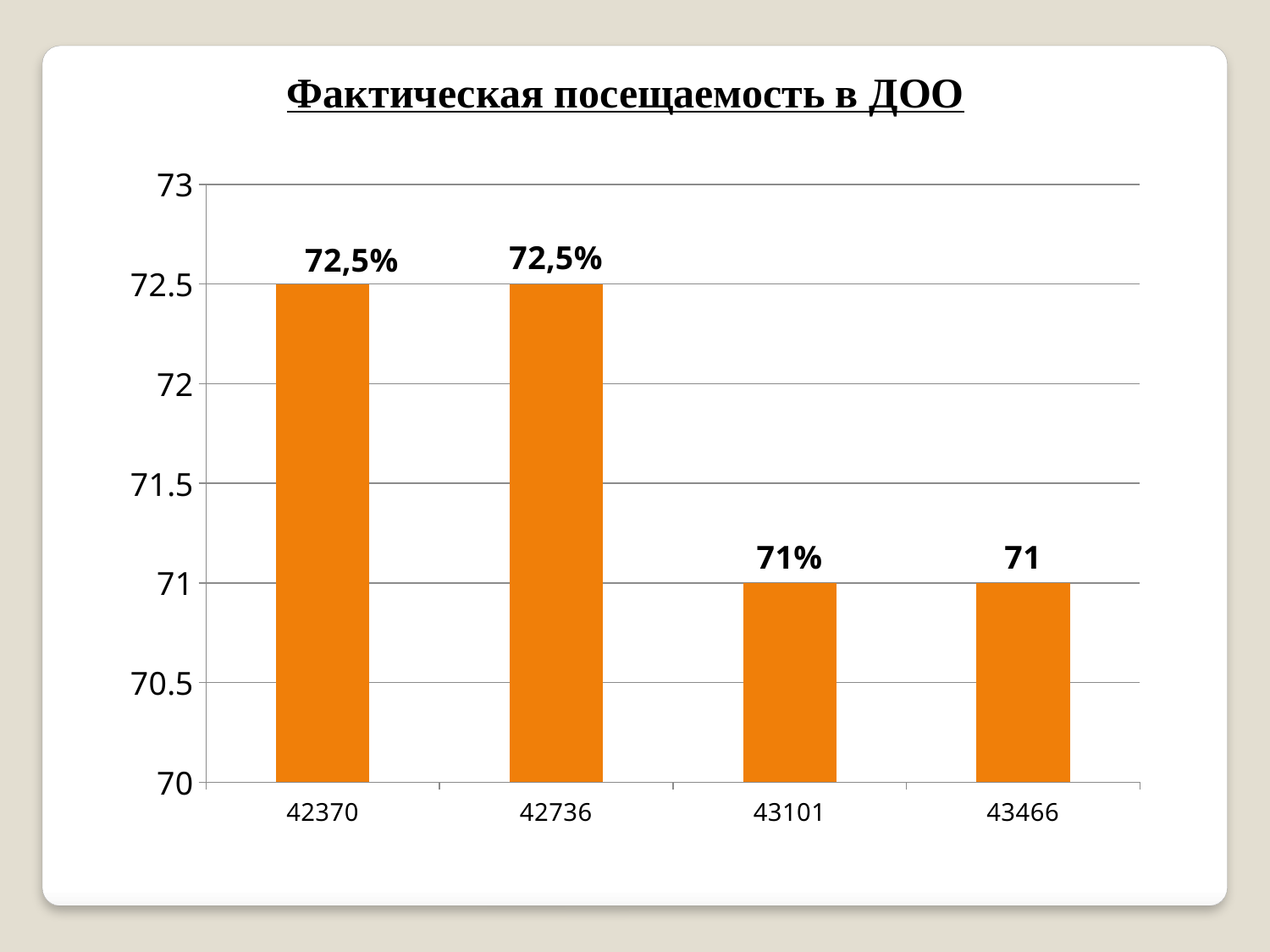
Which is larger, the value for 42370 or the value for 43101? 42370 What is the value for 43101? 71% What kind of chart is shown on the slide? bar chart Is the value for 43101 greater or less than 72? less Which is larger, the value for 42736 or the value for 43466? 42736 What is the value for 42736? 72,5% What is the data label shown on the bar for 43466? 71 What is the difference between the value for 42736 and the value for 43101? 1,5% What is the value for 42370? 72,5% How many bars are plotted in the chart? 4 What is the title of the chart? Фактическая посещаемость в ДОО Do the values rise or fall from left to right along the x axis? fall